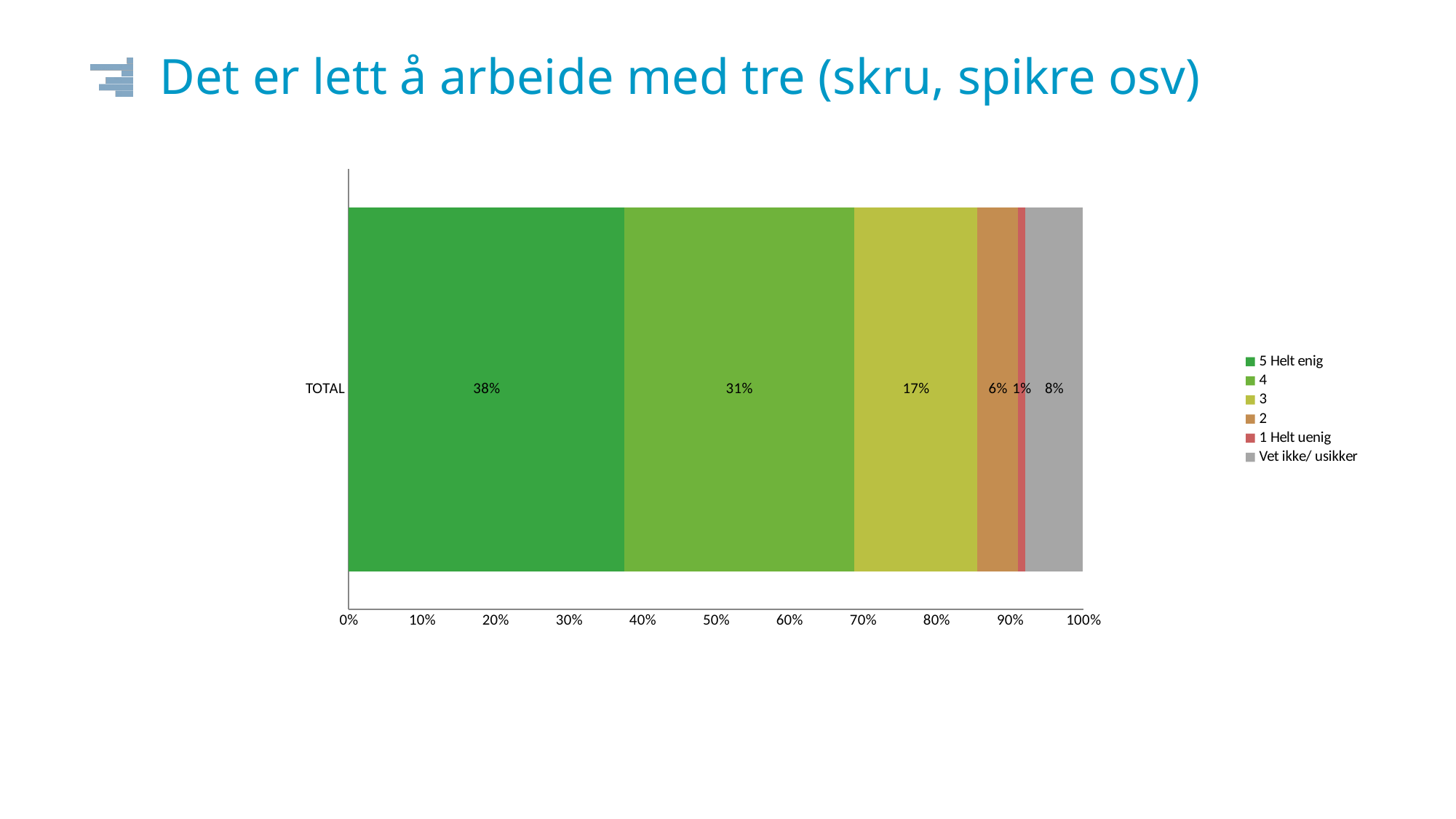
What is the title of the slide containing the chart? Det er lett å arbeide med tre (skru, spikre osv) What percentage of respondents answered '5 Helt enig'? 38% Which series has the largest share of the TOTAL bar? 5 Helt enig What share of the TOTAL bar is 'Vet ikke/ usikker'? 8% How many series does the legend list? 6 What kind of chart is shown on the slide? Stacked bar chart Which series has the smallest share of the TOTAL bar? 1 Helt uenig What is the value for the '4' series in the TOTAL bar? 31% Which is larger, the value for '3' or the value for 'Vet ikke/ usikker'? 3 What is the value for '1 Helt uenig'? 1% What is the combined value of '5 Helt enig' and '4'? 69% What is the difference between the '5 Helt enig' and '4' values? 7%